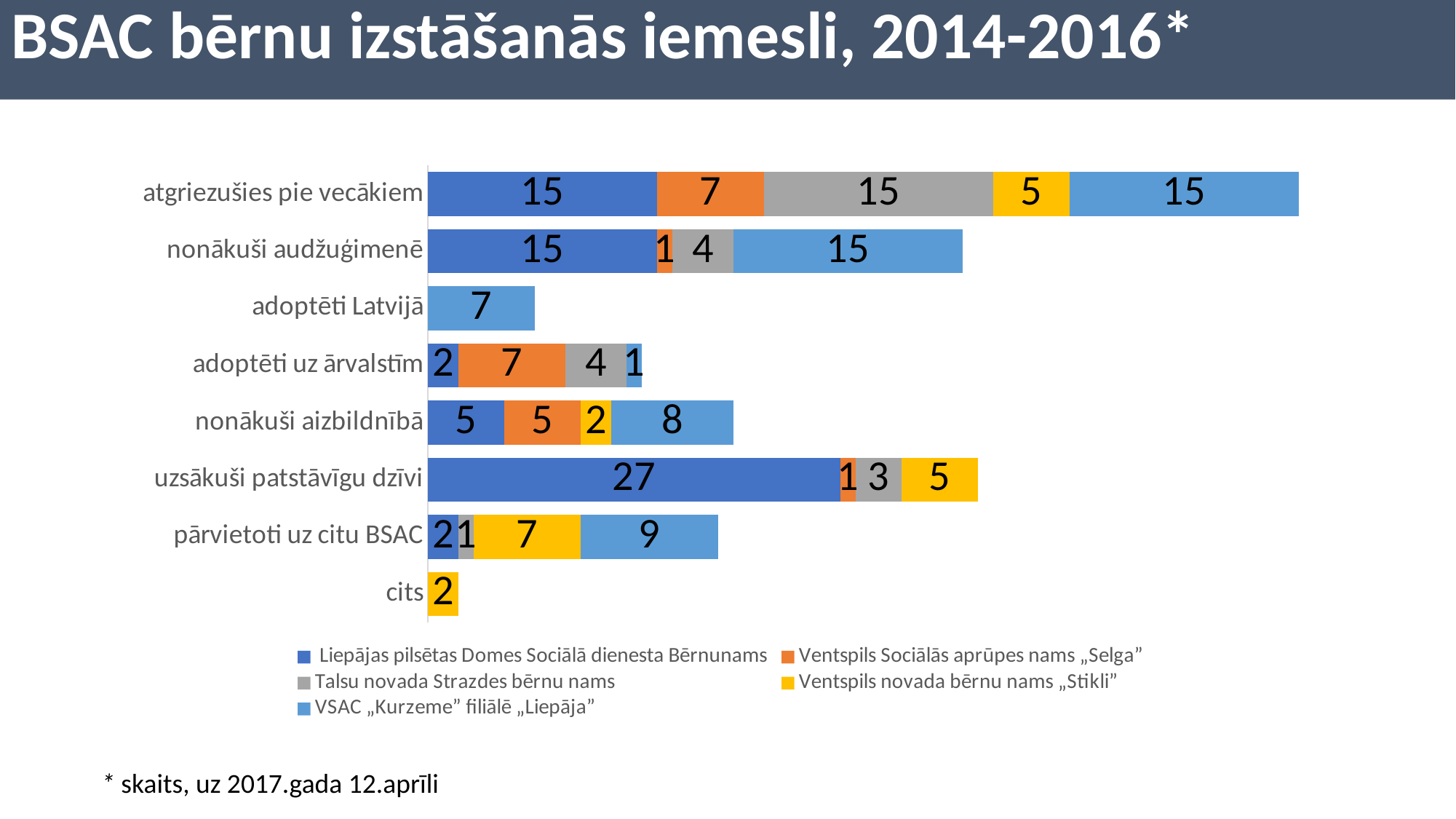
What is the value for Ventspils novada bērnu nams „Stikli” in the category 'pārvietoti uz citu BSAC'? 7 What kind of chart is shown on the slide? stacked bar chart What is the value for VSAC „Kurzeme” filiālē „Liepāja” in the category 'adoptēti Latvijā'? 7 What is the total of the stacked bar for 'atgriezušies pie vecākiem'? 57 Which category has the longest stacked bar overall? atgriezušies pie vecākiem What is the difference between the Liepājas pilsētas Domes Sociālā dienesta Bērnunams value for 'uzsākuši patstāvīgu dzīvi' and its value for 'nonākuši audžuģimenē'? 12 How many categories are shown on the vertical axis of the chart? 8 How many series does the chart legend list? 5 What is the total of the stacked bar for 'nonākuši aizbildnībā'? 20 Which is larger: the VSAC „Kurzeme” filiālē „Liepāja” value for 'pārvietoti uz citu BSAC' or for 'nonākuši aizbildnībā'? pārvietoti uz citu BSAC What is the value for Liepājas pilsētas Domes Sociālā dienesta Bērnunams in the category 'uzsākuši patstāvīgu dzīvi'? 27 What is the value for Ventspils Sociālās aprūpes nams „Selga” in the category 'adoptēti uz ārvalstīm'? 7